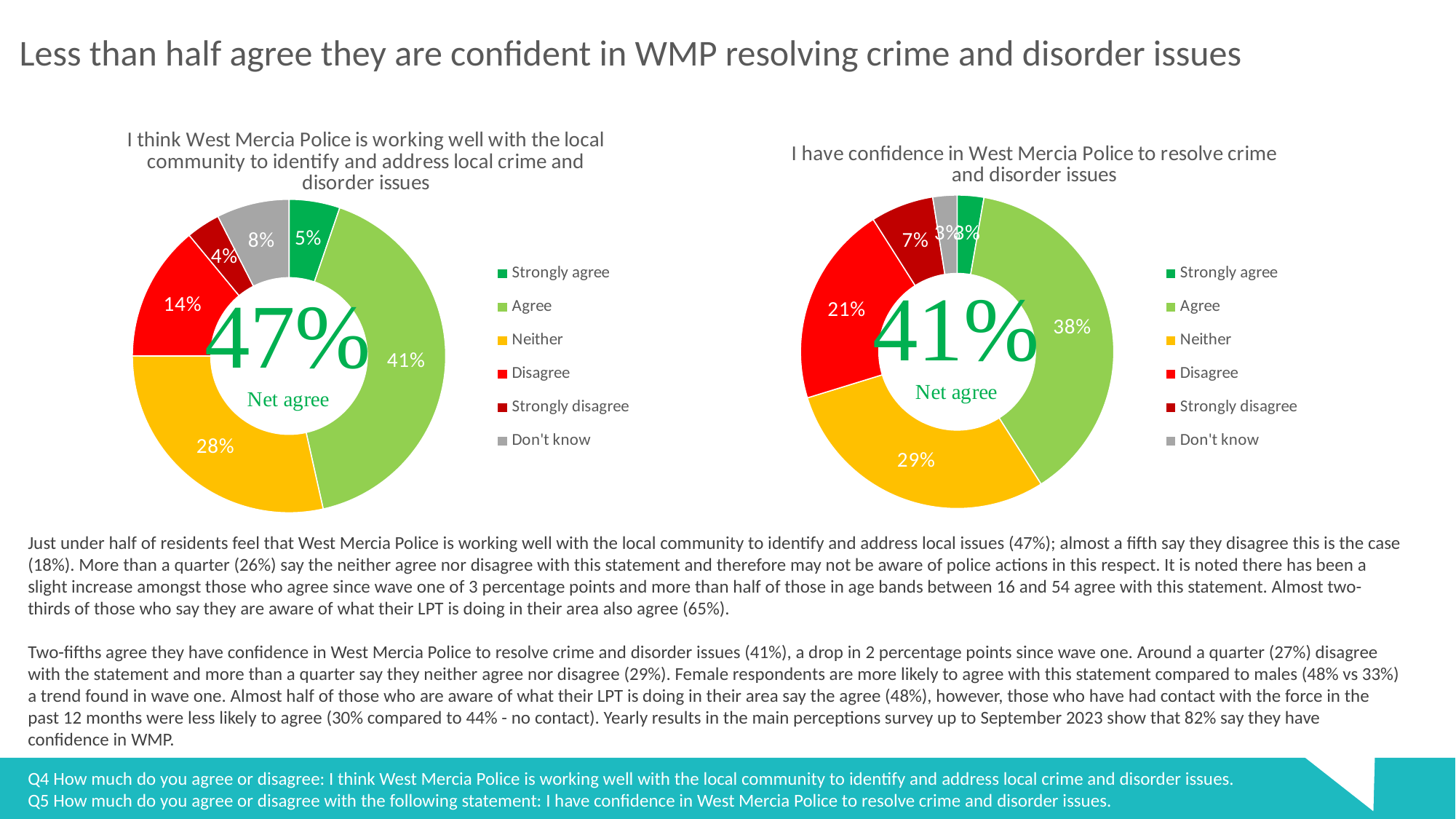
In the left chart ('I think West Mercia Police is working well...'), how many response categories are shown in the legend? 6 What type of chart is used on this slide? Doughnut (pie) chart In the right chart ('I have confidence in West Mercia Police...'), what is the net agree figure shown in the centre? 41% In the left chart ('I think West Mercia Police is working well...'), what colour represents 'Neither'? Yellow/amber In the right chart ('I have confidence in West Mercia Police...'), what is the combined share of 'Disagree' and 'Strongly disagree'? 28% In the left chart ('I think West Mercia Police is working well with the local community...'), what percentage said 'Neither'? 28% Which chart shows a higher 'Disagree' percentage, the left chart or the right chart? The right chart In the right chart ('I have confidence in West Mercia Police...'), what is the difference between the 'Agree' and 'Disagree' percentages? 17 percentage points In the right chart ('I have confidence in West Mercia Police to resolve crime and disorder issues'), what percentage said 'Disagree'? 21% In the left chart ('I think West Mercia Police is working well with the local community...'), what percentage of respondents said 'Agree'? 41% In the left chart ('I think West Mercia Police is working well...'), which response category has the largest share? Agree In the left chart ('I think West Mercia Police is working well...'), which response category has the smallest share? Strongly disagree